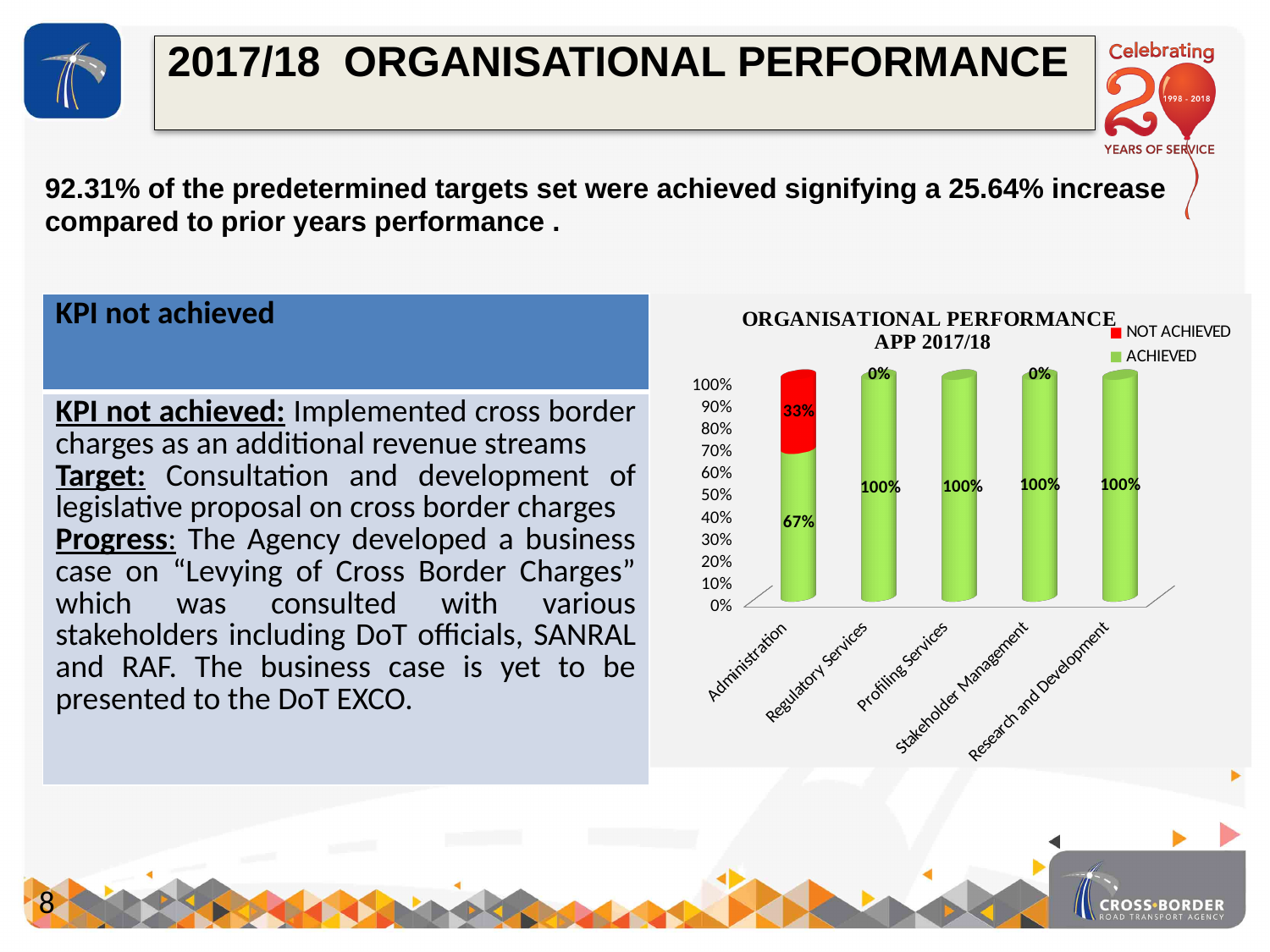
Which category has the lowest ACHIEVED value? Administration What is the NOT ACHIEVED value for Administration? 33% What is the ACHIEVED value for Administration? 67% What is the ACHIEVED value for Regulatory Services? 100% What is the difference between the ACHIEVED values for Profiling Services and Administration? 33% Is the ACHIEVED value for Administration greater or less than 50%? greater How many categories are shown on the x axis? 5 What is the title of the chart? ORGANISATIONAL PERFORMANCE APP 2017/18 What is the NOT ACHIEVED value for Stakeholder Management? 0% How many series does the legend list? 2 Which category has the highest NOT ACHIEVED value? Administration What kind of chart is shown? Stacked bar chart